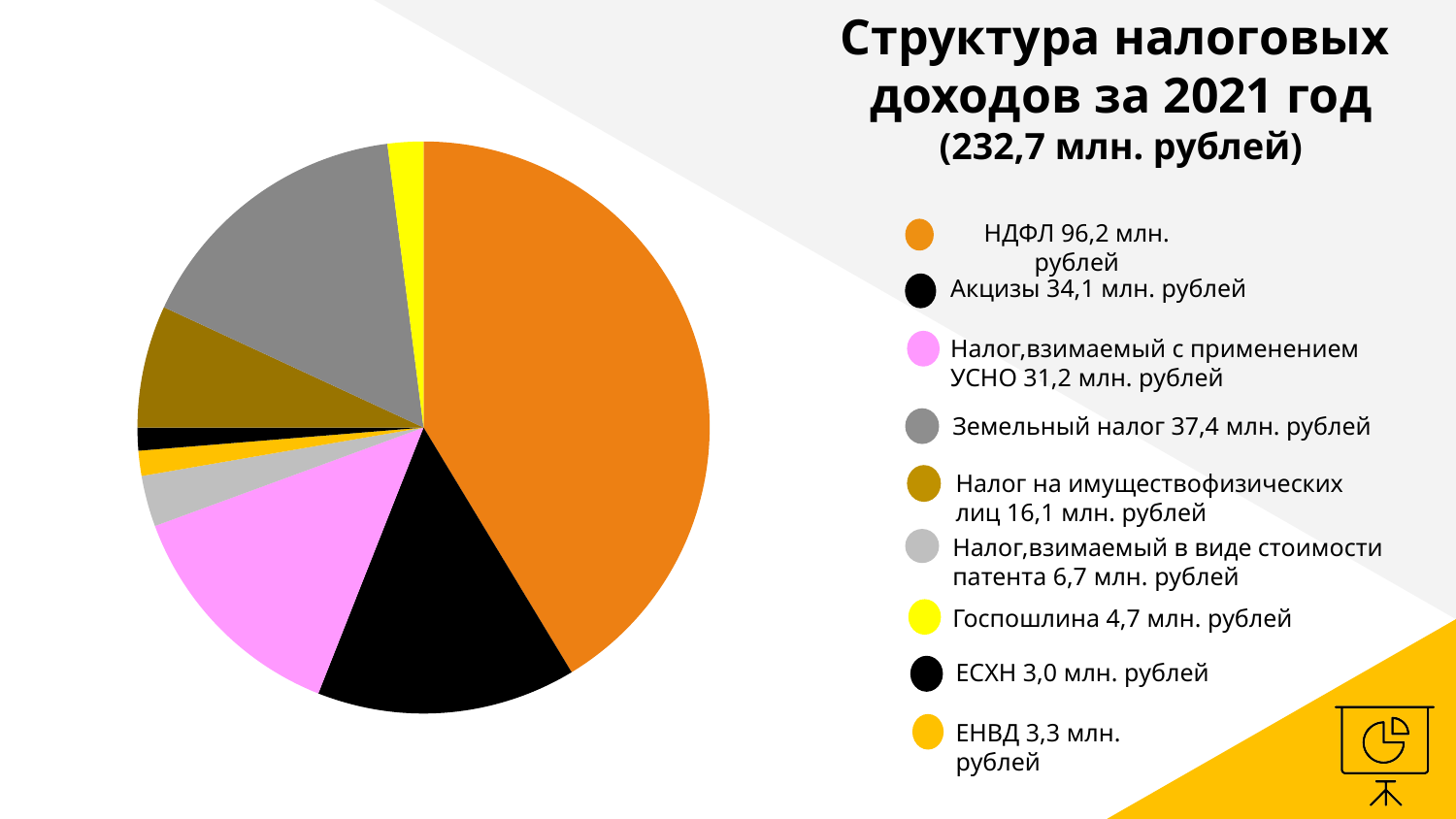
Which category has the largest share of the pie? НДФЛ Which category has the smallest value? ЕСХН What is the value for Земельный налог? 37,4 млн. рублей What total amount is given in the chart title for 2021? 232,7 млн. рублей Which is larger: Акцизы or Налог, взимаемый с применением УСНО? Акцизы What is the difference between НДФЛ and Акцизы? 62,1 млн. рублей How many categories does the pie chart have? 9 What is the difference between Земельный налог and Акцизы? 3,3 млн. рублей What kind of chart is shown on the slide? Pie chart What is the value for Госпошлина? 4,7 млн. рублей What is the value for НДФЛ? 96,2 млн. рублей What is the value for Налог, взимаемый в виде стоимости патента? 6,7 млн. рублей